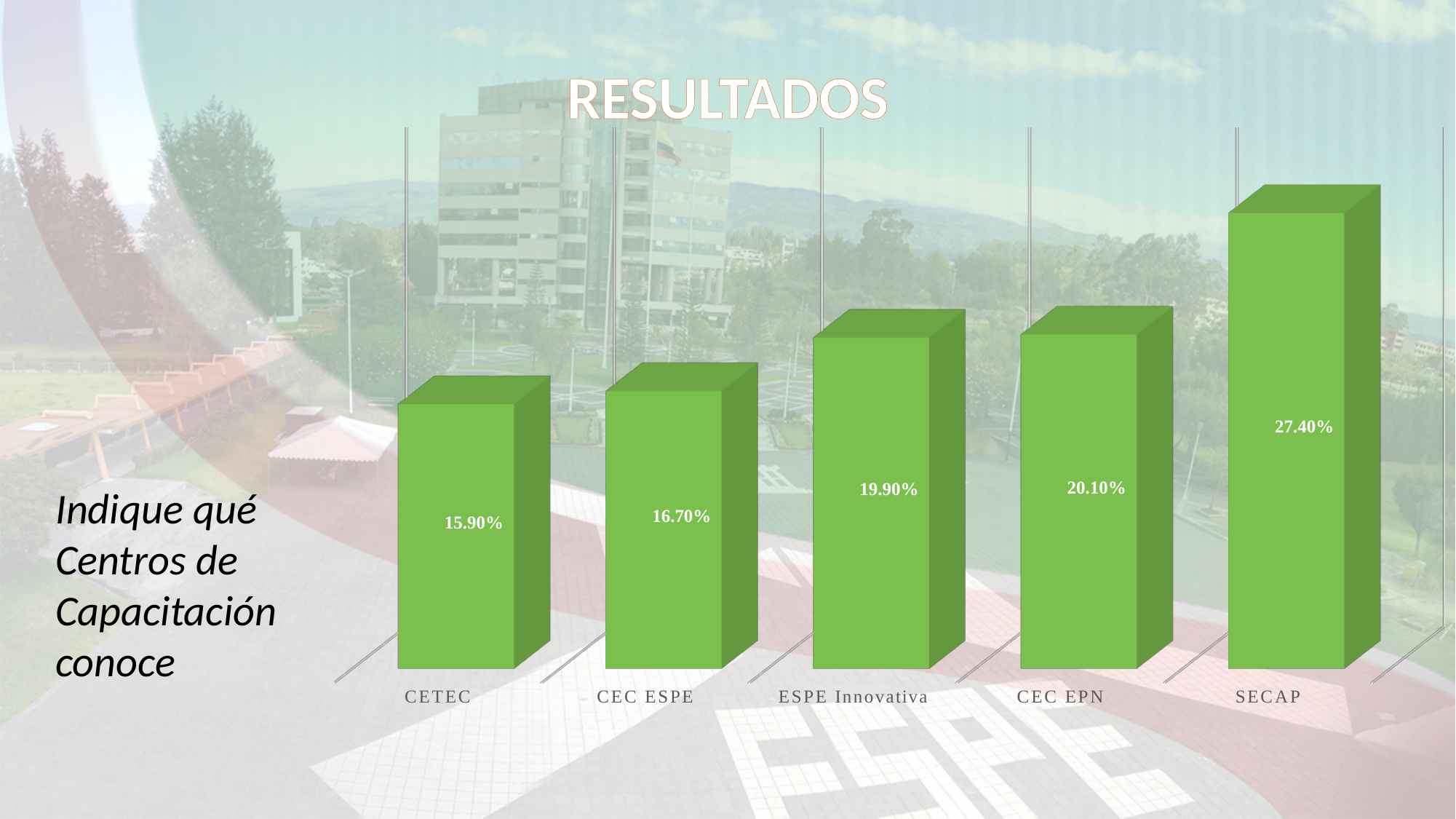
What kind of chart is shown on the slide? Bar chart What is the value for CETEC? 15.90% What is the value for ESPE Innovativa? 19.90% Which training centre has the highest value? SECAP What is the difference between the values for CEC EPN and CEC ESPE? 3.40% What is the value for CEC EPN? 20.10% What is the value for SECAP? 27.40% What is the difference between the values for SECAP and CETEC? 11.50% Which training centre has the lowest value? CETEC Which is larger, the value for ESPE Innovativa or the value for CEC ESPE? ESPE Innovativa How many training centres are shown in the chart? 5 What is the value for CEC ESPE? 16.70%